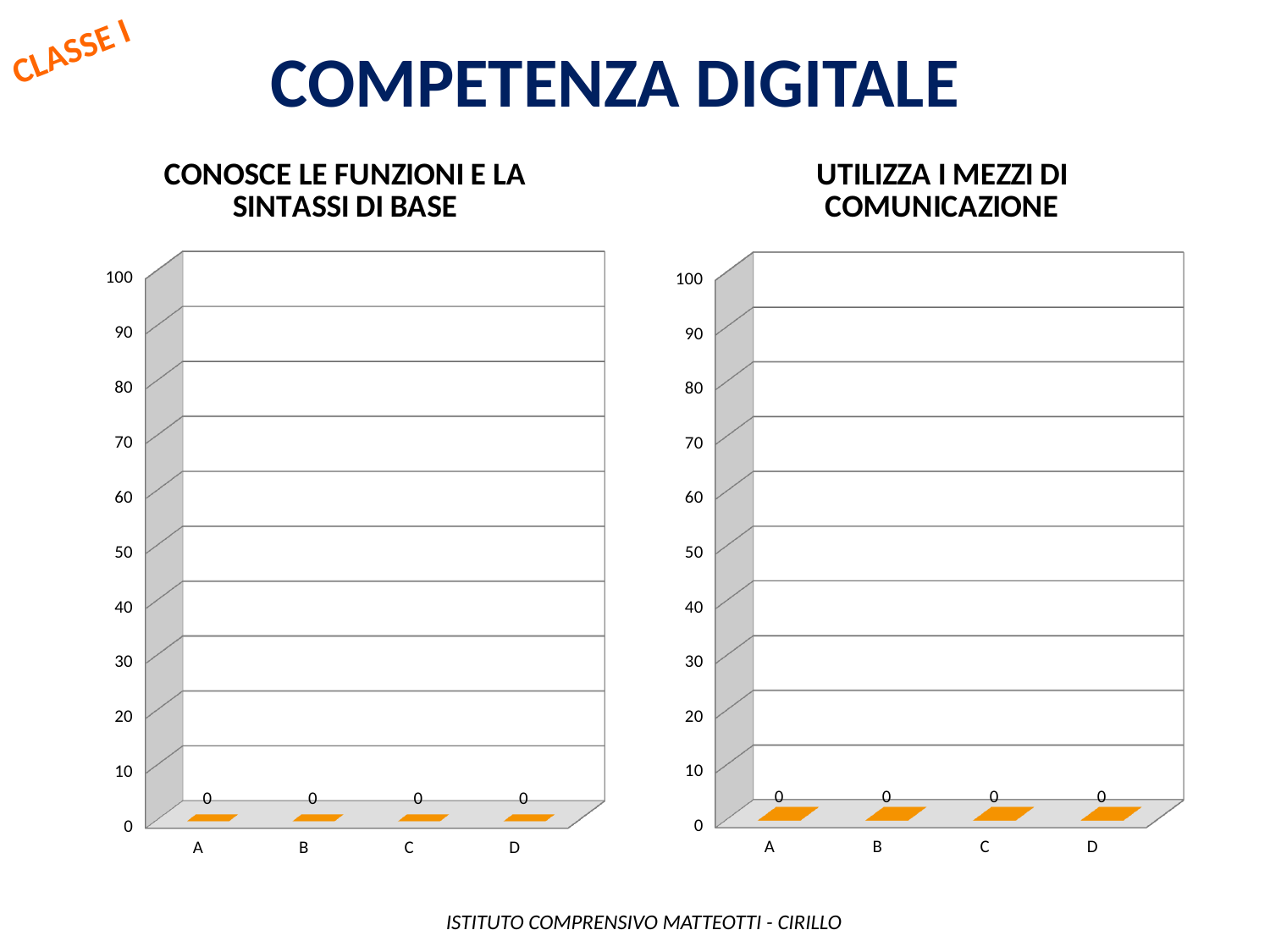
In the chart titled "UTILIZZA I MEZZI DI COMUNICAZIONE", what is the value for category D? 0 In the chart titled "UTILIZZA I MEZZI DI COMUNICAZIONE", what is the value for category B? 0 In the chart titled "CONOSCE LE FUNZIONI E LA SINTASSI DI BASE", what is the value for category C? 0 In the chart titled "CONOSCE LE FUNZIONI E LA SINTASSI DI BASE", what is the value for category A? 0 In the chart titled "CONOSCE LE FUNZIONI E LA SINTASSI DI BASE", is the value for B greater or less than 10? less What kind of chart is the one titled "CONOSCE LE FUNZIONI E LA SINTASSI DI BASE"? Bar chart How many categories are shown on the x axis of the chart titled "CONOSCE LE FUNZIONI E LA SINTASSI DI BASE"? 4 In the chart titled "CONOSCE LE FUNZIONI E LA SINTASSI DI BASE", do the values rise, fall, or stay the same from A to D? Stay the same What is the title of the chart on the left of the slide? CONOSCE LE FUNZIONI E LA SINTASSI DI BASE How many categories are shown on the x axis of the chart titled "UTILIZZA I MEZZI DI COMUNICAZIONE"? 4 In the chart titled "UTILIZZA I MEZZI DI COMUNICAZIONE", what is the difference between the values for A and C? 0 What is the highest value shown on the vertical axis of the chart titled "UTILIZZA I MEZZI DI COMUNICAZIONE"? 100